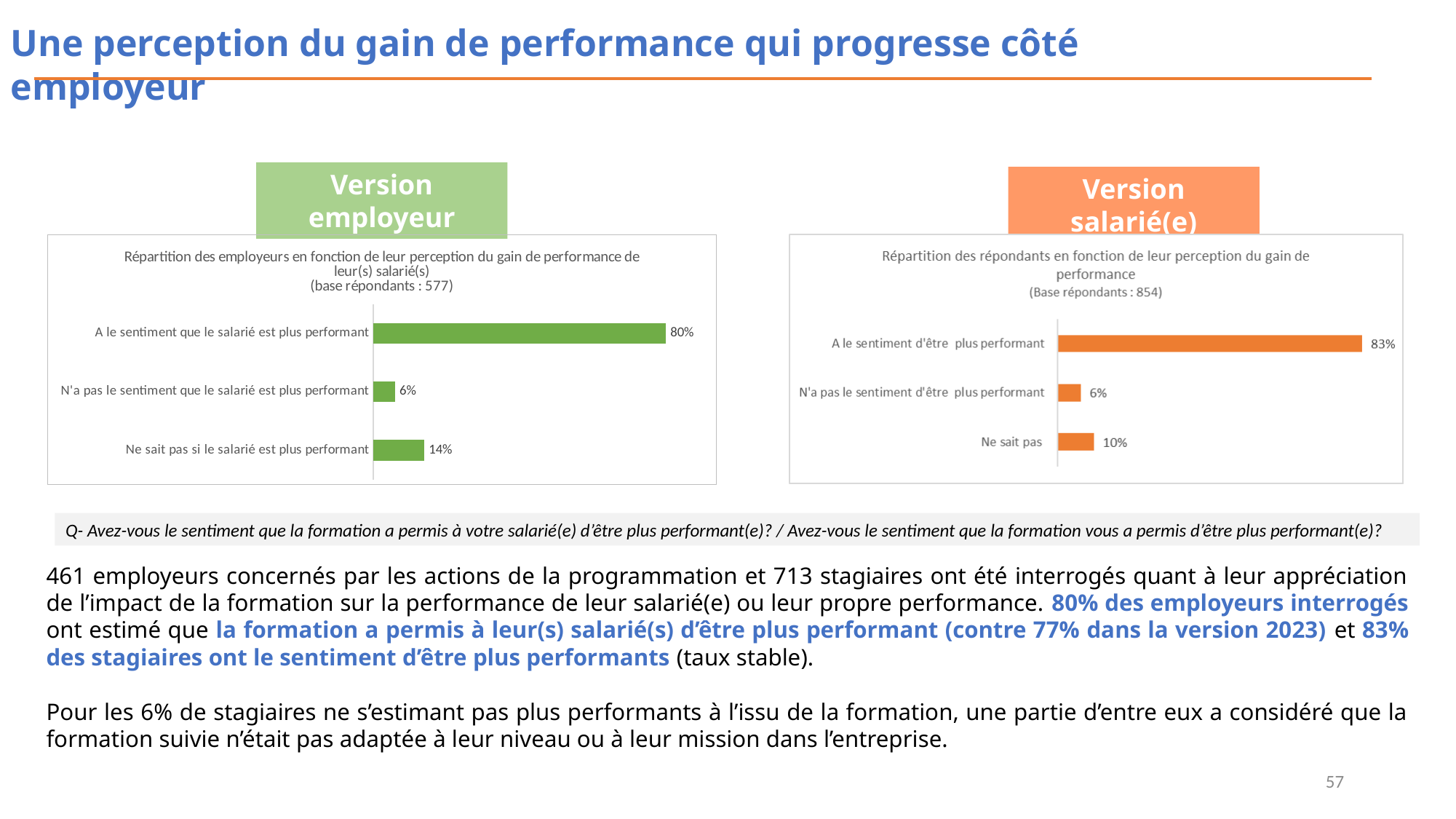
What is the respondent base (base répondants) stated in the title of the right chart (Version salarié(e))? 854 In the left chart (Version employeur), what is the difference between the value for "A le sentiment que le salarié est plus performant" and "Ne sait pas si le salarié est plus performant"? 66% In the left chart (Version employeur), which category has the lowest value? N'a pas le sentiment que le salarié est plus performant How many categories are shown in the left chart (Version employeur)? 3 In the left chart (Version employeur), what is the value for "Ne sait pas si le salarié est plus performant"? 14% In the right chart (Version salarié(e)), what is the value for "Ne sait pas"? 10% What type of chart is used in the right chart (Version salarié(e))? Bar chart In the right chart (Version salarié(e)), which category has the highest value? A le sentiment d'être plus performant In the right chart (Version salarié(e)), what percentage of respondents have the feeling of being more performant ("A le sentiment d'être plus performant")? 83% Which is larger: the share of employers who feel the employee is more performant (left chart) or the share of employees who feel they are more performant (right chart)? Employees (right chart), 83% In the left chart (Version employeur), what percentage of employers have the feeling that the employee is more performant ("A le sentiment que le salarié est plus performant")? 80% In the right chart (Version salarié(e)), what is the difference between "Ne sait pas" and "N'a pas le sentiment d'être plus performant"? 4%